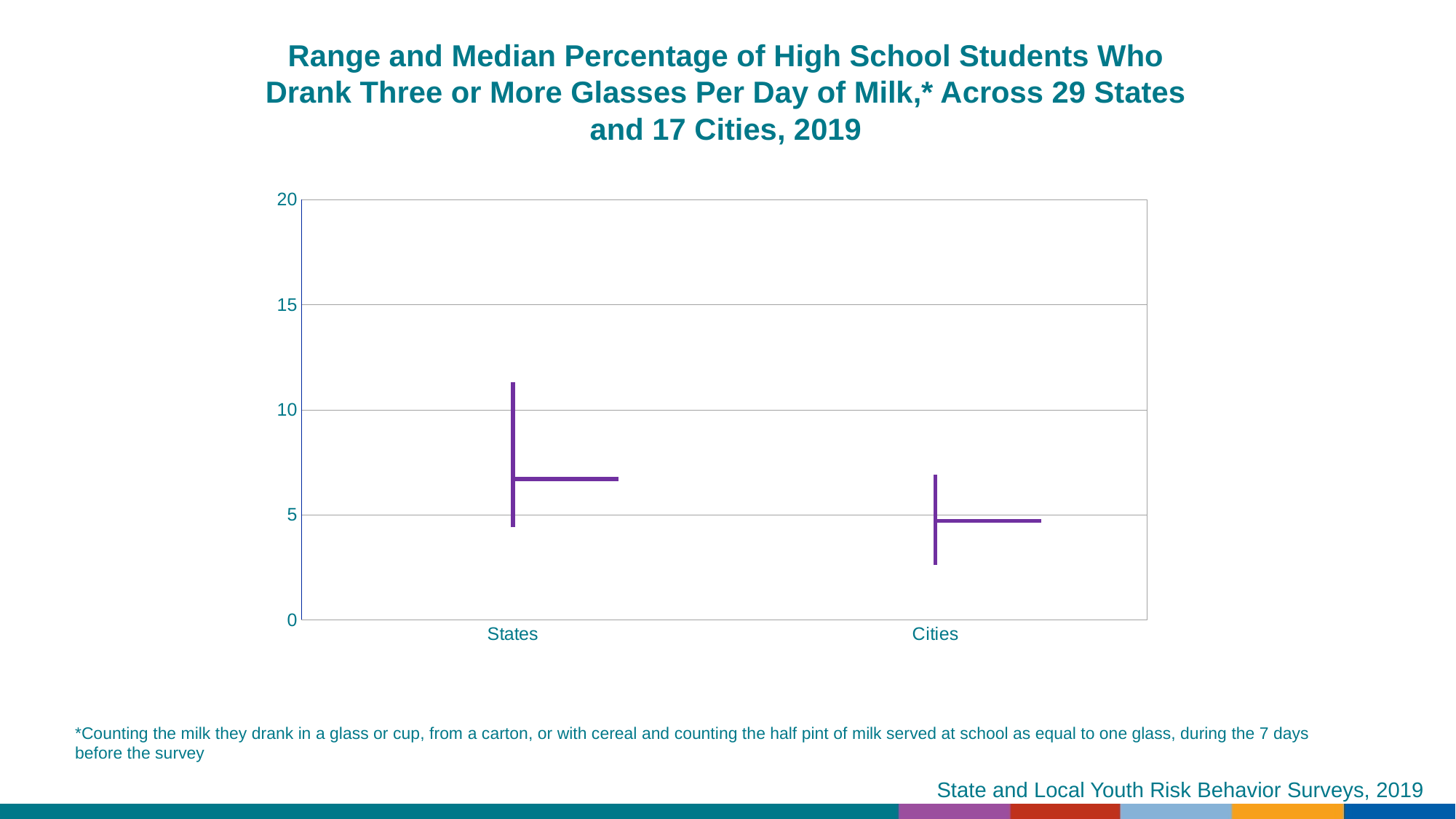
Which category has the lower bottom of its range? Cities What kind of chart is this? A range (high-low) chart with median markers How many categories are shown on the x axis of the chart? 2 What is the maximum value shown on the y axis? 20 Is the median value for States greater or less than 5? greater Is the top of the range for States greater or less than 15? less Is the top of the range for Cities greater or less than 10? less Which category has the higher top of its range? States What are the two categories shown on the x axis? States and Cities Which category has the higher median percentage, States or Cities? States